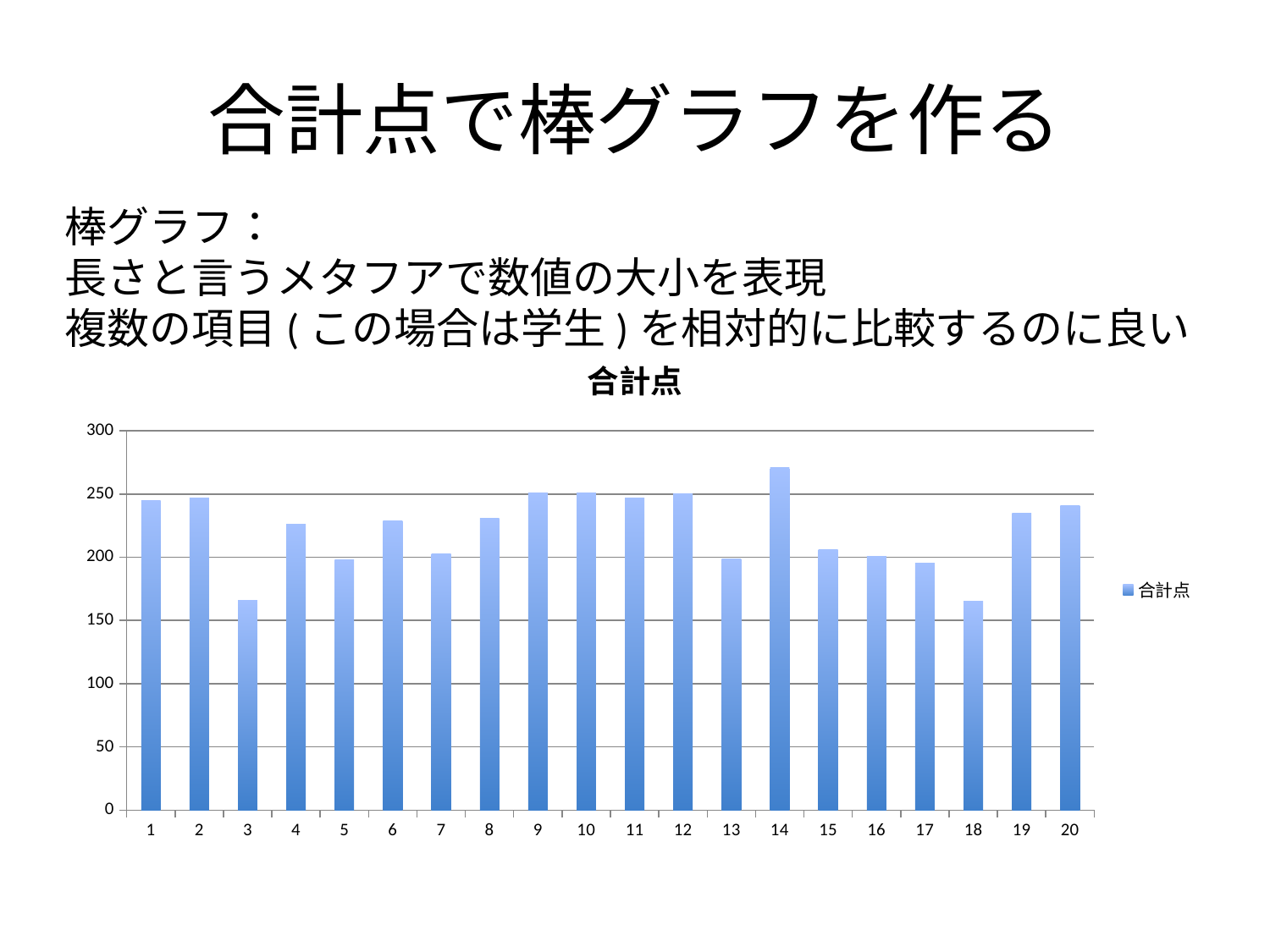
Which is larger, the value for category 4 or the value for category 7? 4 Which is larger, the value for category 14 or the value for category 3? 14 What is the title of the chart? 合計点 Is the value for category 14 greater or less than 250? greater What kind of chart is shown on the slide? bar chart How many series does the chart's legend list? 1 How many categories are plotted along the x axis of the chart? 20 Is the value for category 3 greater or less than 200? less Is the value for category 19 greater or less than 200? greater Which is larger, the value for category 18 or the value for category 19? 19 Which category has the highest value in the chart? 14